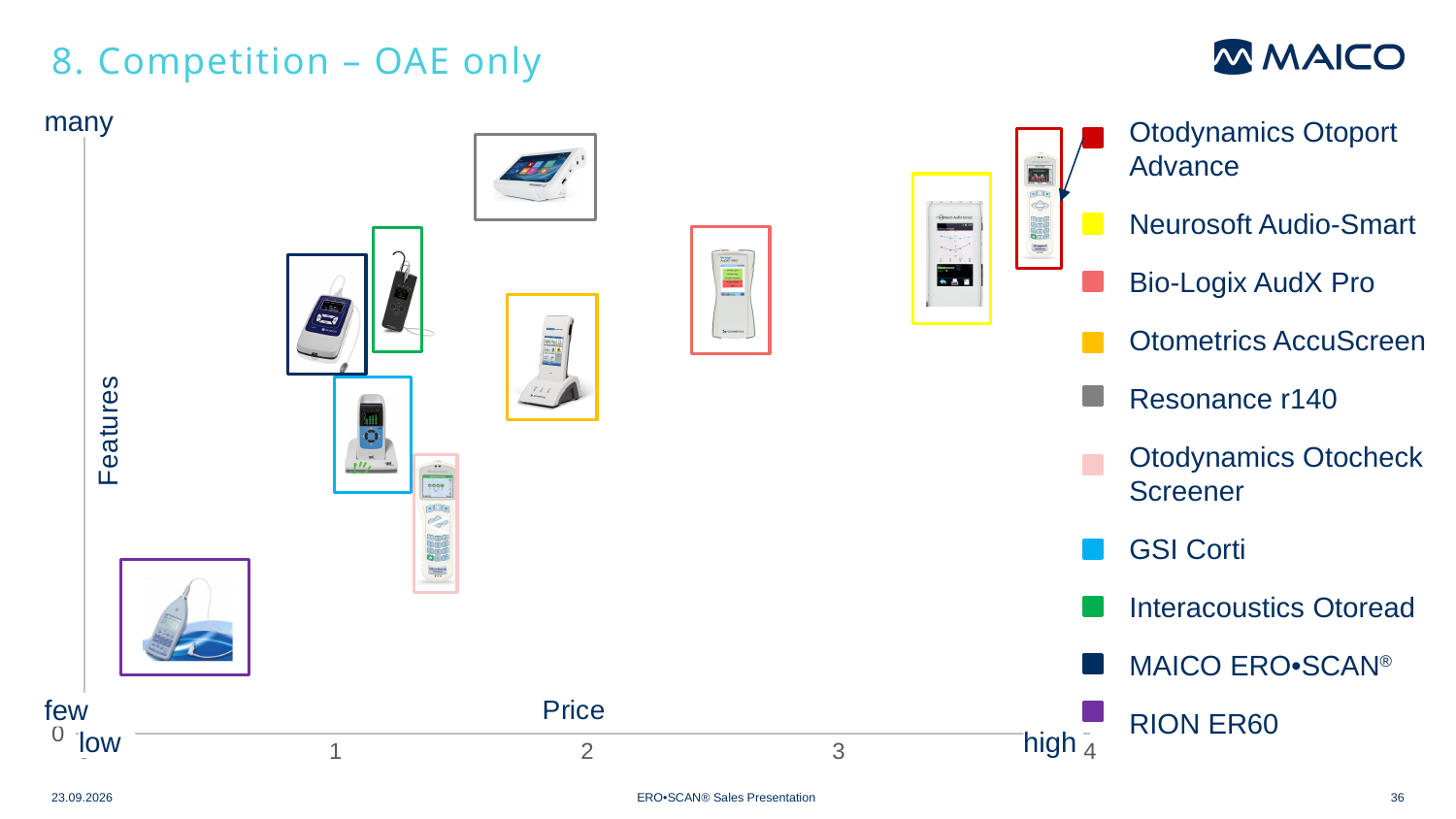
What kind of chart is shown on the slide? scatter chart Which product is positioned furthest to the right on the Price axis? Otodynamics Otoport Advance How many products are plotted on the chart? 10 Which product has a higher price position, Neurosoft Audio-Smart or GSI Corti? Neurosoft Audio-Smart Is the price position for RION ER60 greater or less than 1? less Which product is positioned highest on the Features axis? Resonance r140 Is the price position for Otodynamics Otoport Advance greater or less than 3? greater How many products does the legend list? 10 Is the price position for Bio-Logix AudX Pro greater or less than 2? greater What is the label of the horizontal axis? Price Which product is positioned lowest on the Features axis? RION ER60 Which product is positioned furthest to the left on the Price axis? RION ER60